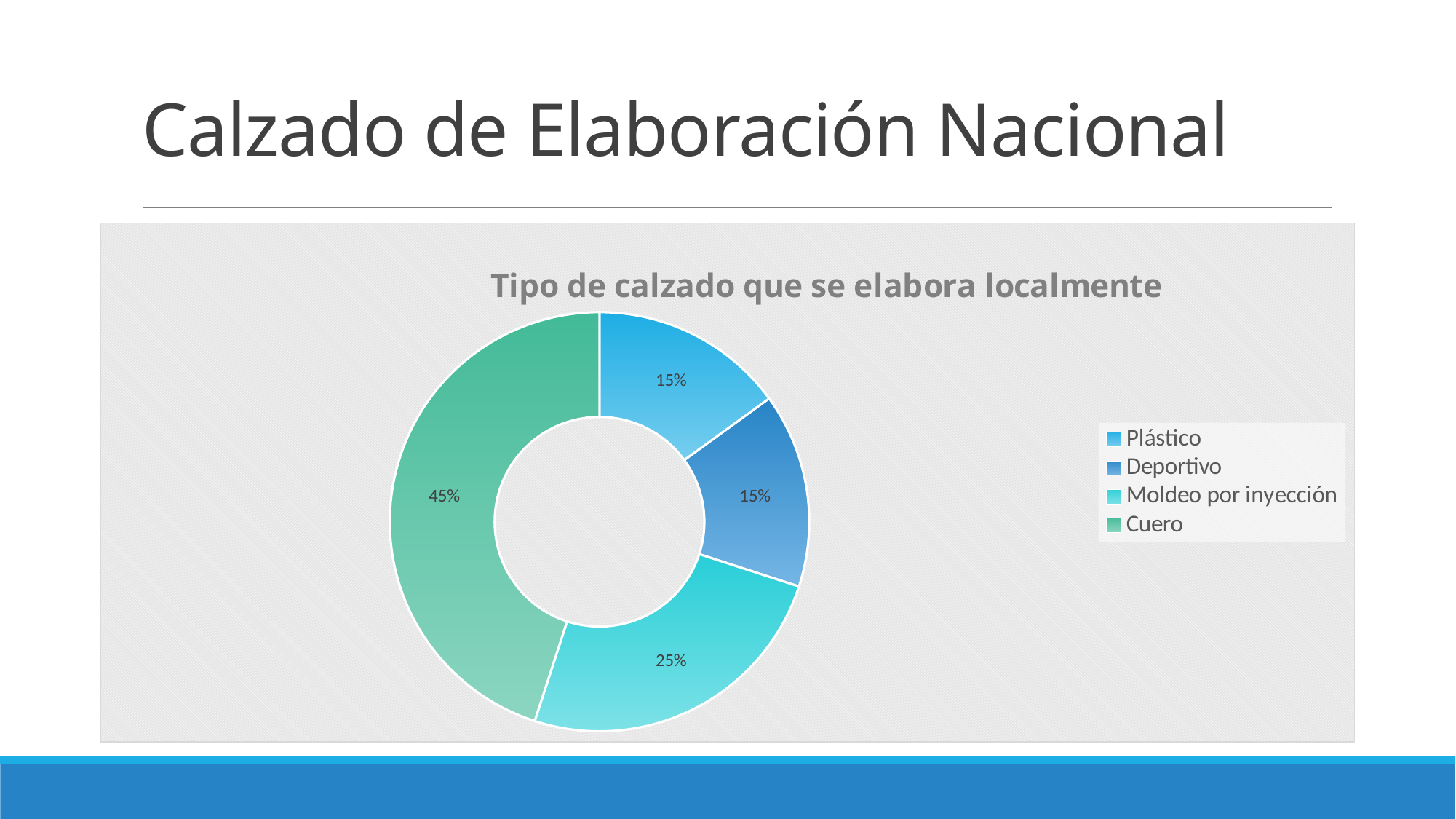
What is the combined share of Plástico and Deportivo? 30% What percentage does Deportivo account for? 15% What is the title of the chart? Tipo de calzado que se elabora localmente What is the difference between the shares of Cuero and Moldeo por inyección? 20% Which category has the largest share? Cuero How many categories does the legend list? 4 What percentage does Cuero account for? 45% What kind of chart is shown on the slide? Doughnut chart Which legend entry is shown in green? Cuero Which is larger, the share of Moldeo por inyección or the share of Plástico? Moldeo por inyección What percentage does Plástico account for? 15% What percentage does Moldeo por inyección account for? 25%